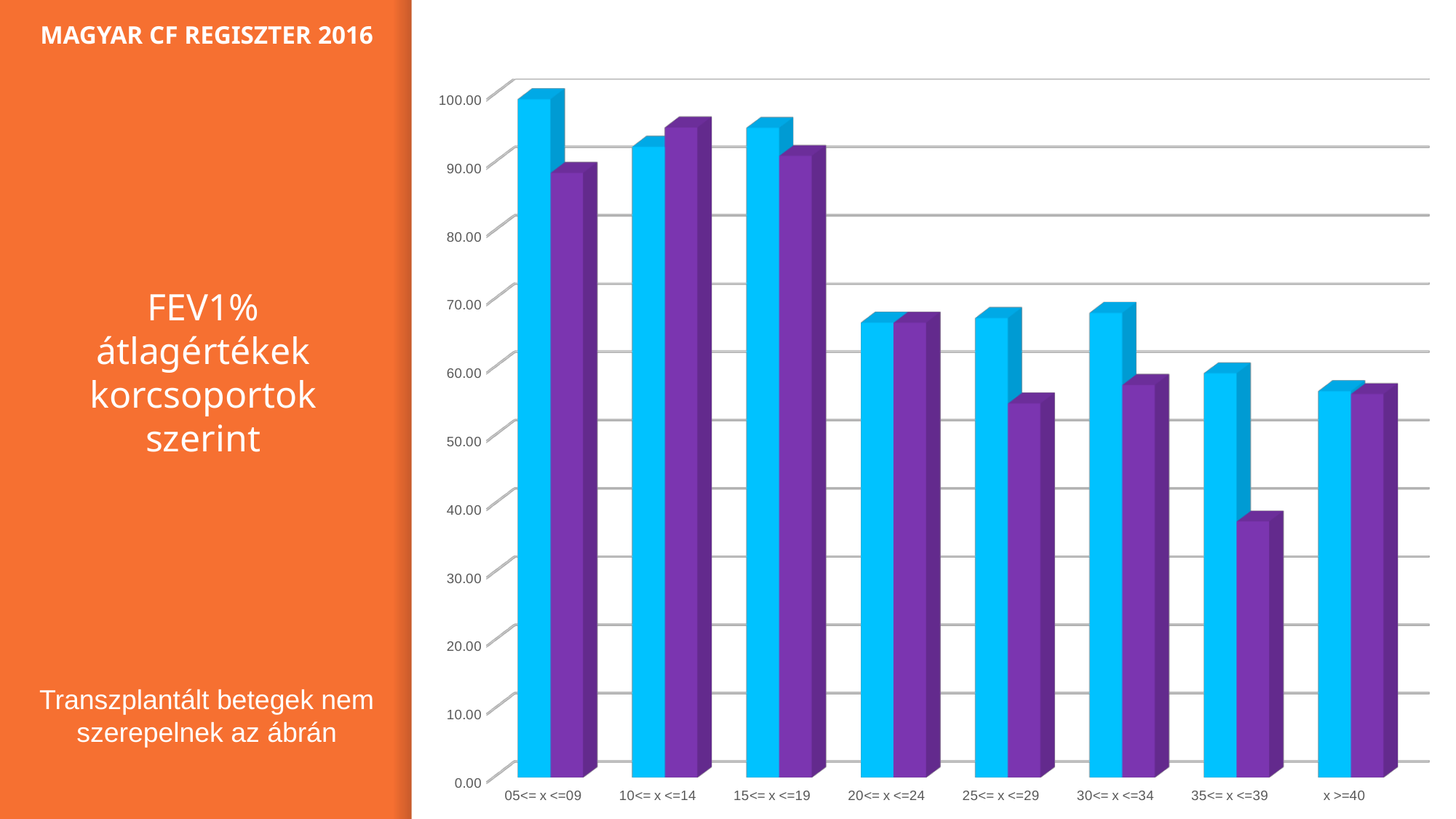
For the 10<= x <=14 age group, which bar is taller, the blue or the purple one? purple Do the values generally rise or fall as the age groups get older along the x axis? fall Is the blue bar for 05<= x <=09 greater or less than 90.00? greater Which age group has the highest value for the blue series? 05<= x <=09 Is the purple bar for 25<= x <=29 greater or less than 60.00? less Is the purple bar for 35<= x <=39 greater or less than 50.00? less Which age group has the lowest value for the purple series? 35<= x <=39 What is the title of the chart given on the slide? FEV1% átlagértékek korcsoportok szerint What kind of chart is shown on the slide? bar chart For the 35<= x <=39 age group, which bar is taller, the blue or the purple one? blue How many age-group categories are shown on the x axis? 8